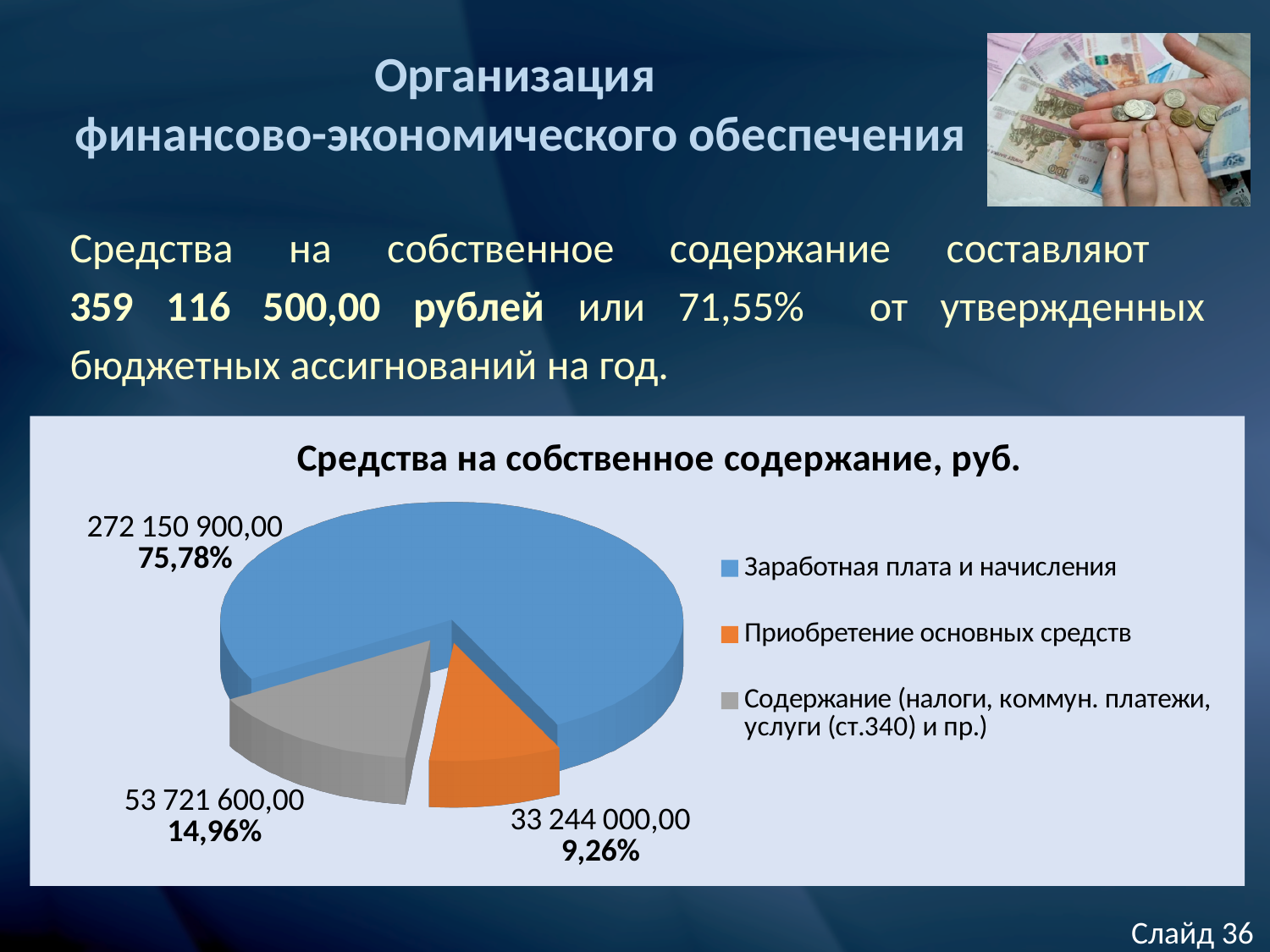
What is the title of the chart? Средства на собственное содержание, руб. What share of the pie does Заработная плата и начисления take? 75,78% What type of chart is shown on the slide? pie chart What is the difference between the values for Содержание (налоги, коммун. платежи, услуги (ст.340) и пр.) and Приобретение основных средств? 20 477 600,00 How many slices does the pie chart have? 3 How many entries does the chart legend list? 3 Which category has the largest slice? Заработная плата и начисления What share of the pie does Приобретение основных средств take? 9,26% What is the value for Заработная плата и начисления? 272 150 900,00 What is the value for Содержание (налоги, коммун. платежи, услуги (ст.340) и пр.)? 53 721 600,00 Which category has the smallest slice? Приобретение основных средств What is the value for Приобретение основных средств? 33 244 000,00